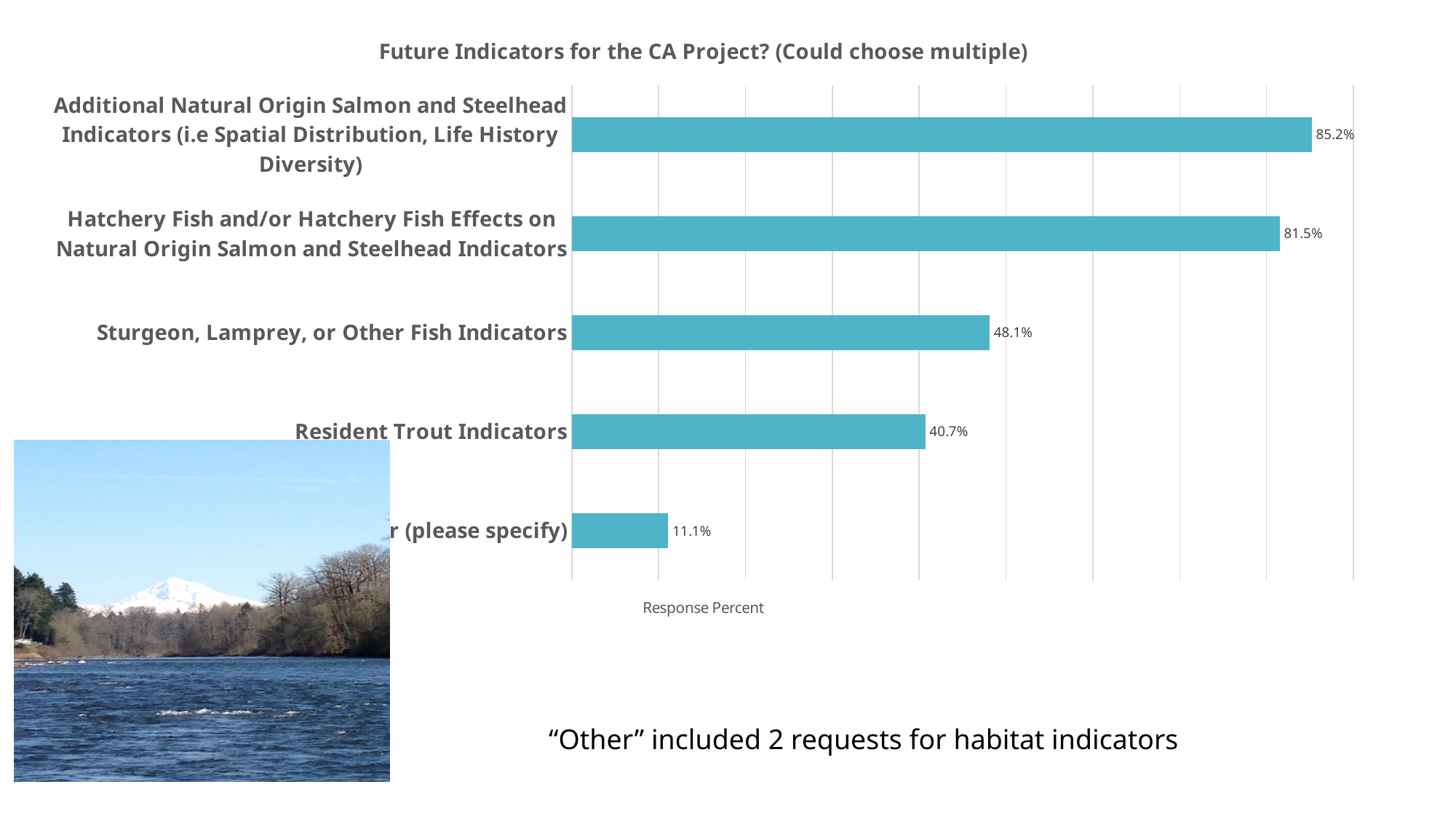
What is the response percent for Resident Trout Indicators? 40.7% Which has a higher response percent: Hatchery Fish and/or Hatchery Fish Effects on Natural Origin Salmon and Steelhead Indicators or Resident Trout Indicators? Hatchery Fish and/or Hatchery Fish Effects on Natural Origin Salmon and Steelhead Indicators What is the label on the horizontal axis of the chart? Response Percent What is the response percent for Hatchery Fish and/or Hatchery Fish Effects on Natural Origin Salmon and Steelhead Indicators? 81.5% How many categories are shown in the chart? 5 Which category has the lowest response percent? Other (please specify) What is the difference in response percent between Sturgeon, Lamprey, or Other Fish Indicators and Resident Trout Indicators? 7.4% What kind of chart is shown on the slide? Bar chart What is the response percent for Sturgeon, Lamprey, or Other Fish Indicators? 48.1% What is the title of the chart? Future Indicators for the CA Project? (Could choose multiple) What is the response percent for Additional Natural Origin Salmon and Steelhead Indicators? 85.2% Which category has the highest response percent? Additional Natural Origin Salmon and Steelhead Indicators